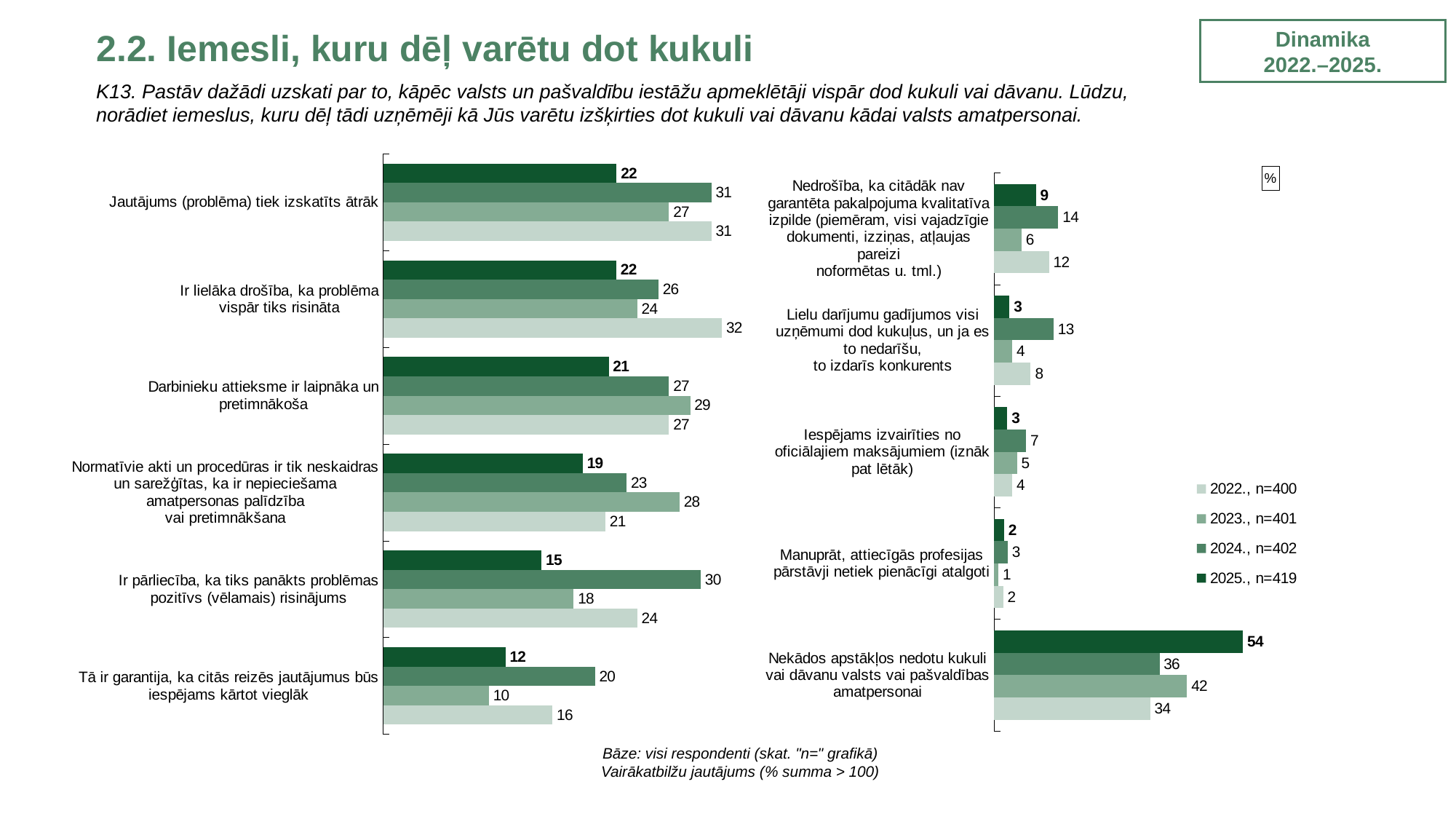
In the right chart, what is the 2024 value for "Lielu darījumu gadījumos visi uzņēmumi dod kukuļus, un ja es to nedarīšu, to izdarīs konkurents"? 13 In the left chart, which category has the lowest 2025 value? Tā ir garantija, ka citās reizēs jautājumus būs iespējams kārtot vieglāk In the left chart, which is larger for "Darbinieku attieksme ir laipnāka un pretimnākoša": the 2023 value or the 2025 value? 2023 How many categories are shown in the left chart? 6 In the right chart, what is the difference between the 2025 and 2022 values for "Nekādos apstākļos nedotu kukuli vai dāvanu valsts vai pašvaldības amatpersonai"? 20 In the right chart, which category has the highest 2022 value? Nekādos apstākļos nedotu kukuli vai dāvanu valsts vai pašvaldības amatpersonai In the left chart, what is the 2022 value for "Ir lielāka drošība, ka problēma vispār tiks risināta"? 32 How many series does the legend list? 4 What type of chart is used on this slide? Bar chart In the left chart, what is the difference between the 2024 and 2025 values for "Ir pārliecība, ka tiks panākts problēmas pozitīvs (vēlamais) risinājums"? 15 In the right chart, what is the 2025 value for "Nekādos apstākļos nedotu kukuli vai dāvanu valsts vai pašvaldības amatpersonai"? 54 In the left chart, what is the 2025 value for "Jautājums (problēma) tiek izskatīts ātrāk"? 22